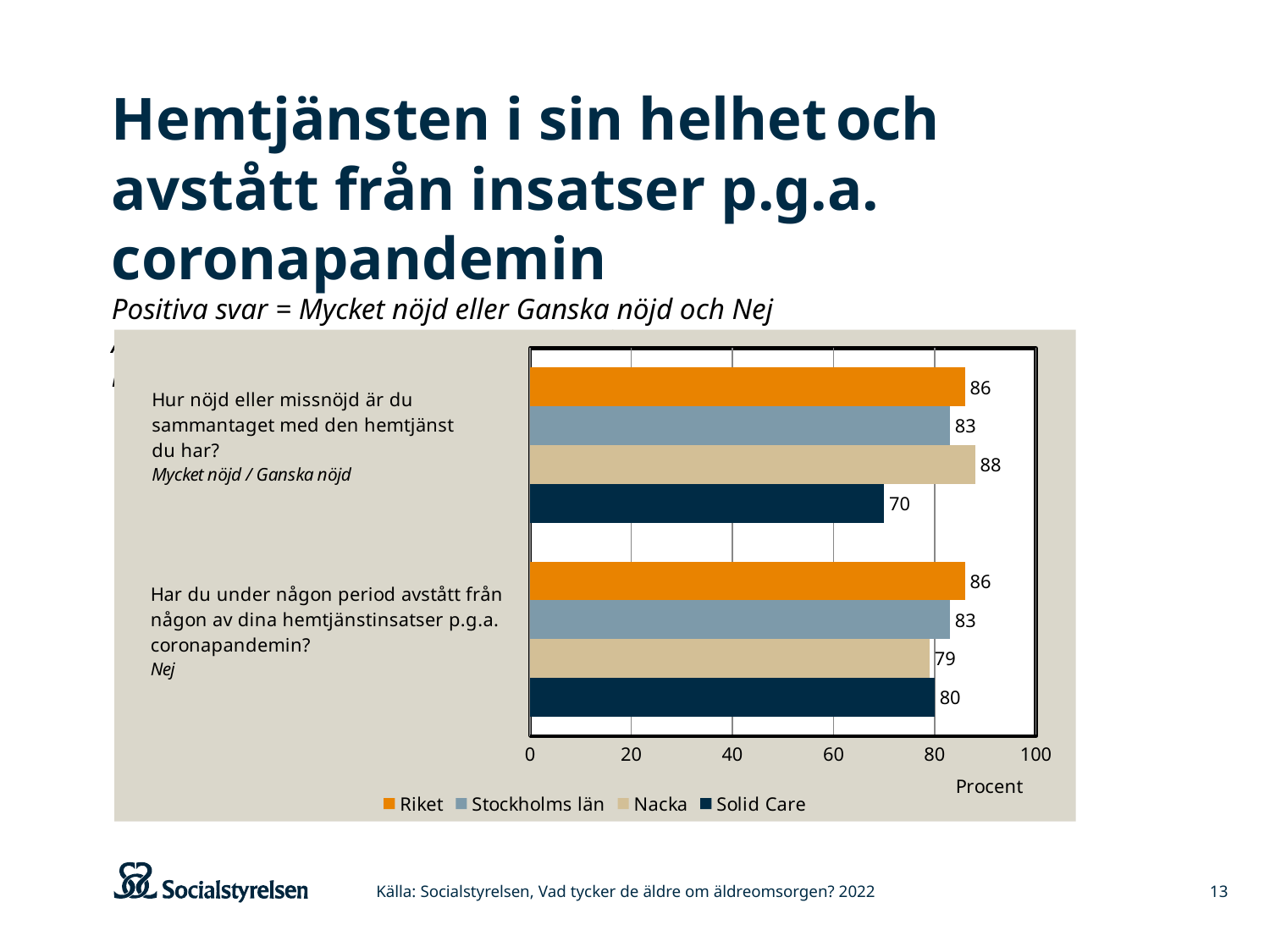
What is the label of the horizontal axis? Procent What is the value for Nacka on the question "Hur nöjd eller missnöjd är du sammantaget med den hemtjänst du har?"? 88 Which series has the lowest value on the question "Har du under någon period avstått från någon av dina hemtjänstinsatser p.g.a. coronapandemin?"? Nacka What is the value for Nacka on the question "Har du under någon period avstått från någon av dina hemtjänstinsatser p.g.a. coronapandemin?"? 79 How many question categories are shown on the chart? 2 What is the value for Riket on the question "Har du under någon period avstått från någon av dina hemtjänstinsatser p.g.a. coronapandemin?"? 86 What is the difference between the Nacka and Solid Care values on the question "Hur nöjd eller missnöjd är du sammantaget med den hemtjänst du har?"? 18 What is the value for Solid Care on the question "Hur nöjd eller missnöjd är du sammantaget med den hemtjänst du har?"? 70 How many series does the legend list? 4 What kind of chart is shown on the slide? bar chart Which is larger on the question "Har du under någon period avstått från någon av dina hemtjänstinsatser p.g.a. coronapandemin?": Stockholms län or Solid Care? Stockholms län Which series has the highest value on the question "Hur nöjd eller missnöjd är du sammantaget med den hemtjänst du har?"? Nacka